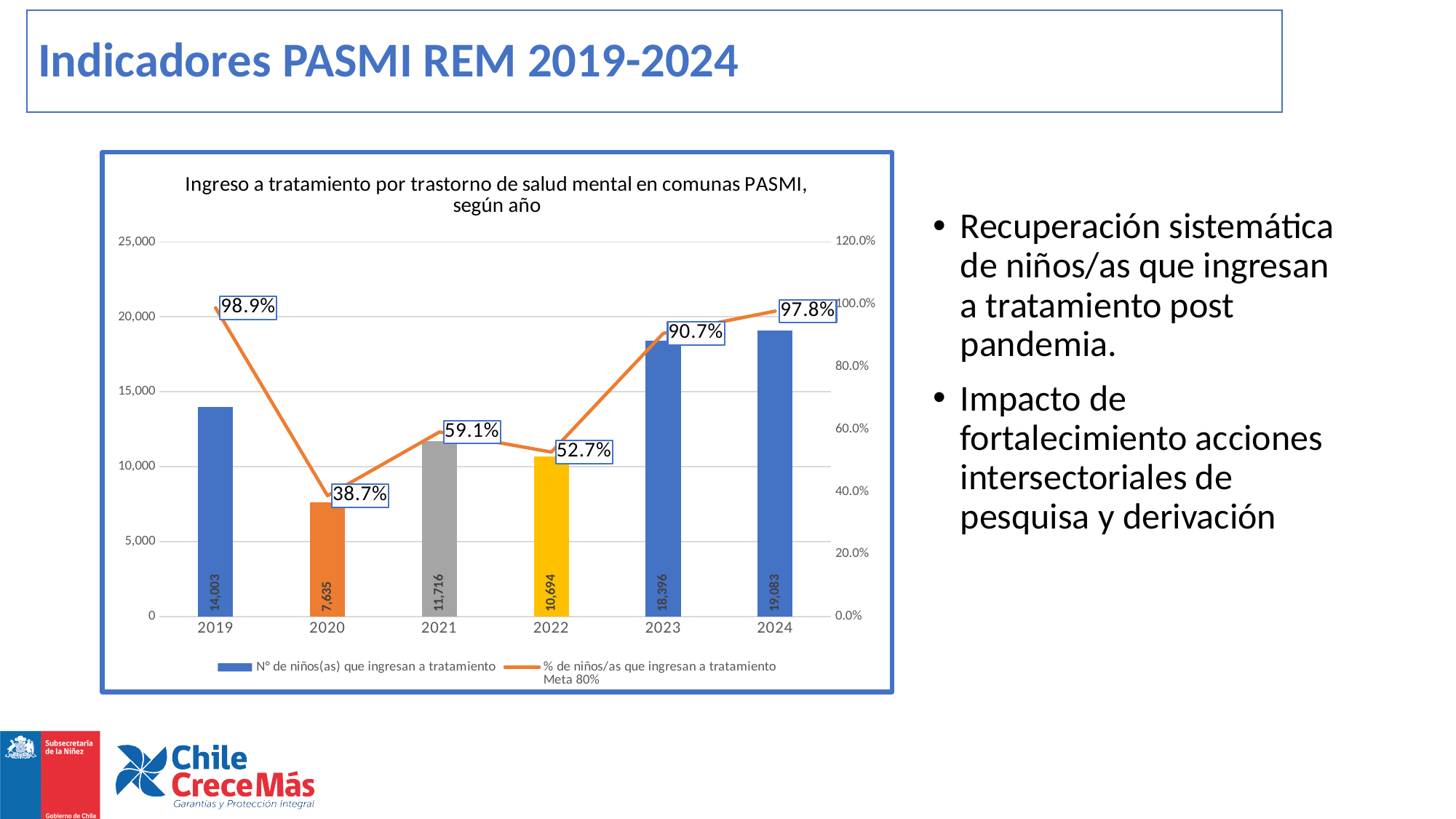
What is the difference between the number of children entering treatment in 2024 and in 2020? 11,448 How many years are shown on the x axis of the chart? 6 Which year has the lowest percentage of children entering treatment? 2020 What is the number of children entering treatment in 2023? 18,396 What is the number of children entering treatment in 2021? 11,716 Is the number of children entering treatment in 2022 greater or less than 10,000? greater Which year has the highest number of children entering treatment? 2024 Does the percentage of children entering treatment rise or fall from 2022 to 2024? rise How many series does the chart legend list? 2 What target (meta) is mentioned in the legend of the chart? Meta 80% What percentage of children entering treatment is shown for 2020? 38.7% Which year has a higher percentage of children entering treatment, 2019 or 2024? 2019